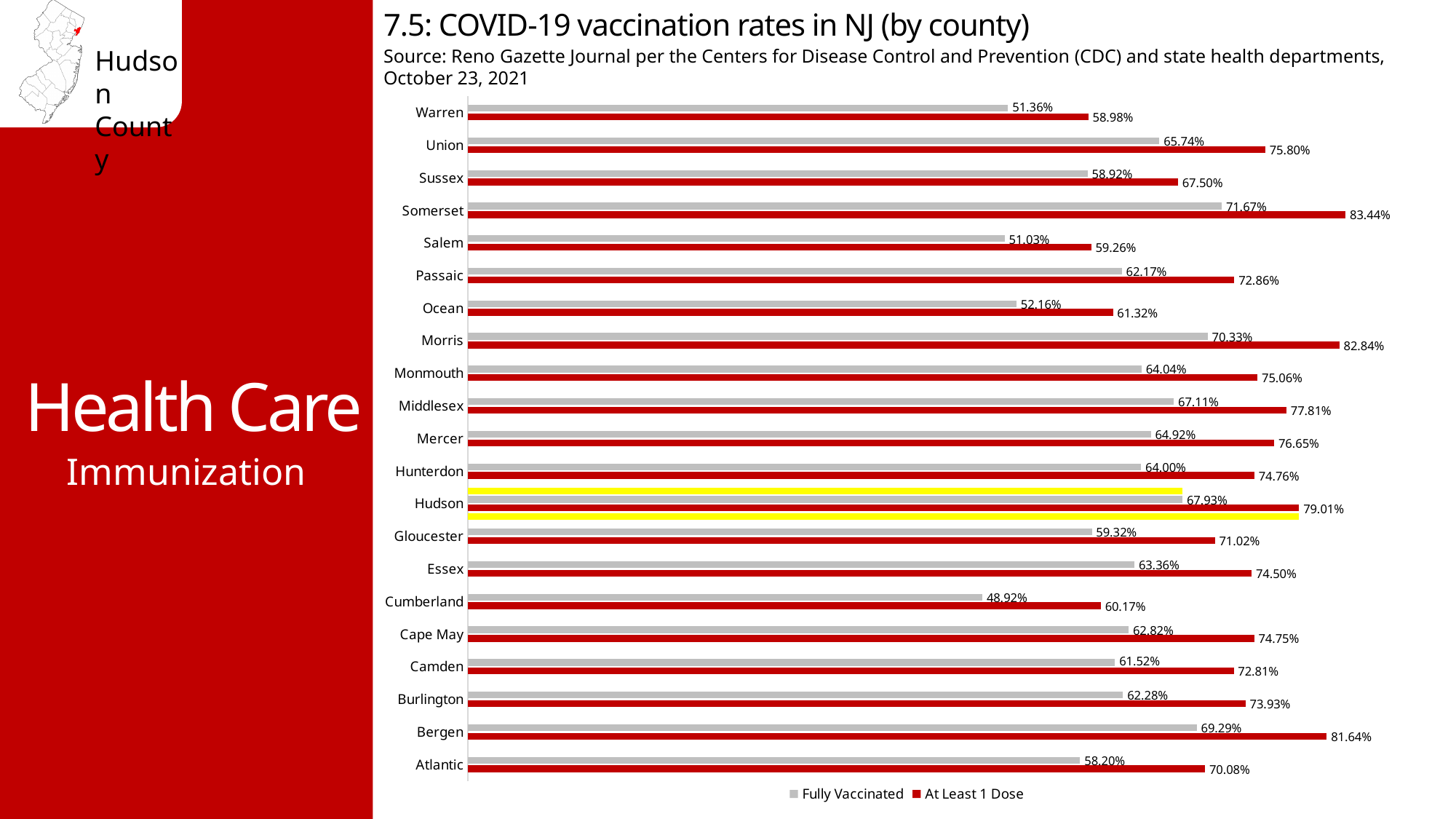
Which series is shown in red in the chart? At Least 1 Dose What is the At Least 1 Dose rate for Somerset county? 83.44% Which county has the lowest At Least 1 Dose rate? Warren How many counties are shown in the chart? 21 Which county has the highest Fully Vaccinated rate? Somerset What is the Fully Vaccinated rate for Cumberland county? 48.92% Which county has a higher At Least 1 Dose rate, Bergen or Morris? Morris How many series does the legend list? 2 What is the Fully Vaccinated rate for Hudson county? 67.93% What is the difference between the At Least 1 Dose rate and the Fully Vaccinated rate for Hudson county? 11.08 percentage points What kind of chart is shown on the slide? Bar chart Which county has the lowest Fully Vaccinated rate? Cumberland